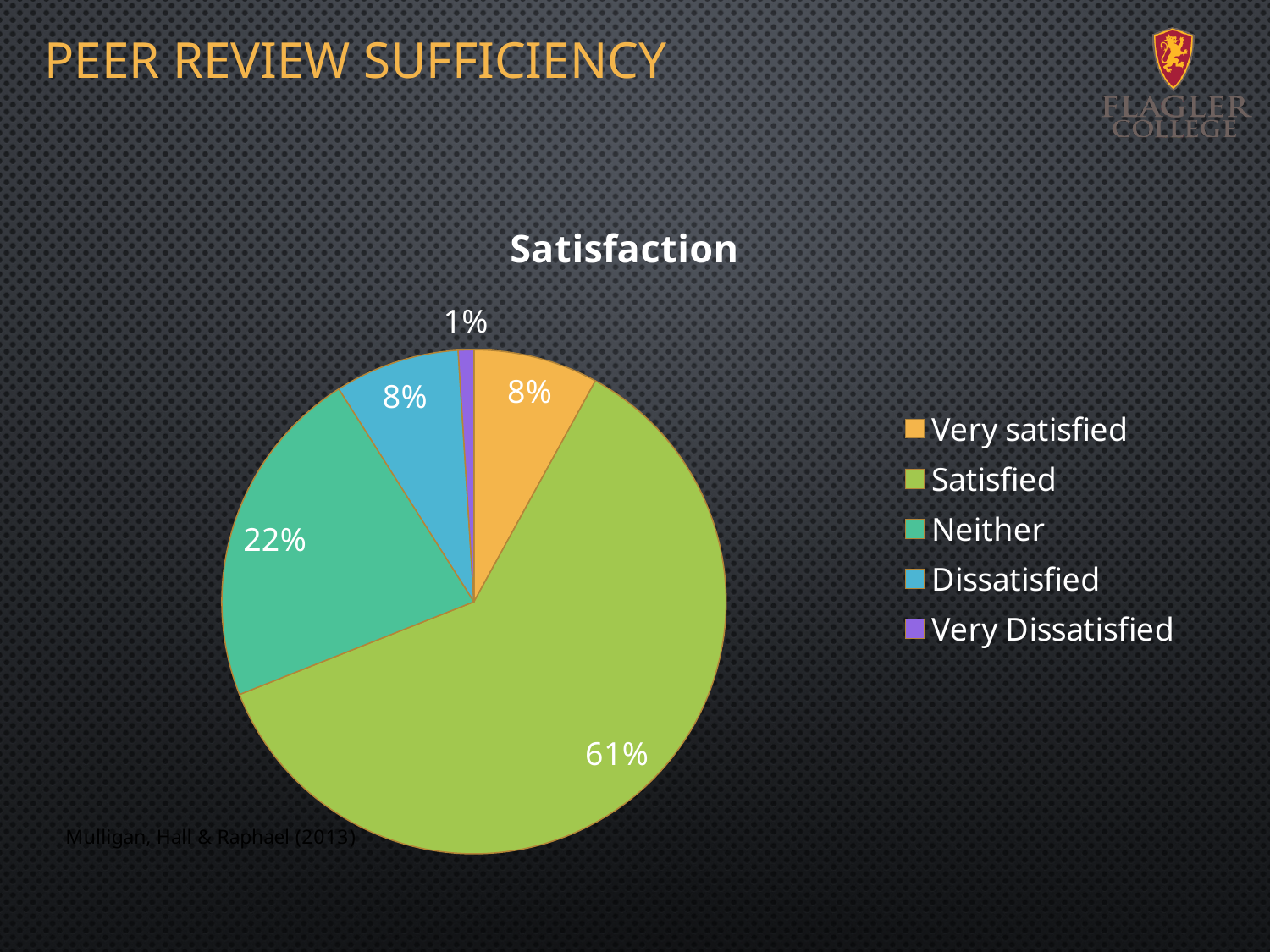
How many categories does the legend list? 5 What colour represents the Satisfied category in the legend? green What percentage of respondents were Very satisfied? 8% What percentage of respondents were Satisfied? 61% What type of chart is shown on the slide? pie chart What percentage of respondents answered Neither? 22% Which category has the smallest share of the pie? Very Dissatisfied What is the title of the chart? Satisfaction What is the difference between the Satisfied and Neither shares? 39% Which category has the largest share of the pie? Satisfied What percentage of respondents were Very Dissatisfied? 1% Which is larger, the Neither share or the Dissatisfied share? Neither